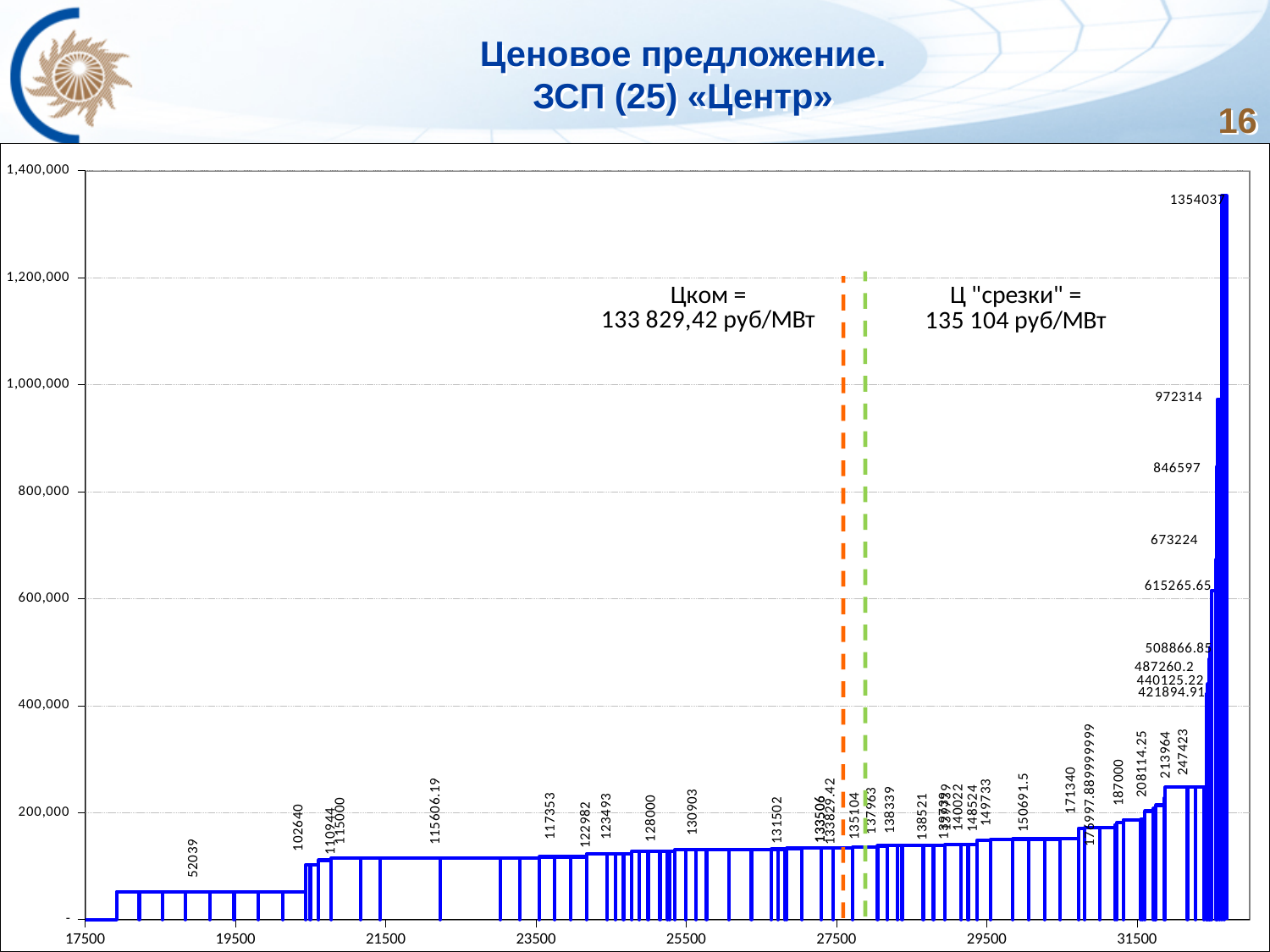
What is the title of the slide containing the chart? Ценовое предложение. ЗСП (25) «Центр» What colour are the plotted bars on the chart? blue Is the value labelled 52039 greater or less than 200,000 on the y axis? less Which is larger, the value labelled 846597 or the value labelled 673224? 846597 What value is given for Цком in the chart annotation? 133 829,42 руб/МВт Is the value labelled 1354037 greater or less than 1,200,000 on the y axis? greater What is the lowest data label shown on the chart? 52039 What is the highest data label shown on the chart? 1354037 What value is given for Ц "срезки" in the chart annotation? 135 104 руб/МВт What is the difference between the Ц "срезки" value and the Цком value shown in the annotations? 1 274,58 руб/МВт What is the second-highest data label shown on the chart? 972314 Do the plotted values rise or fall as you move from left to right along the x axis? rise